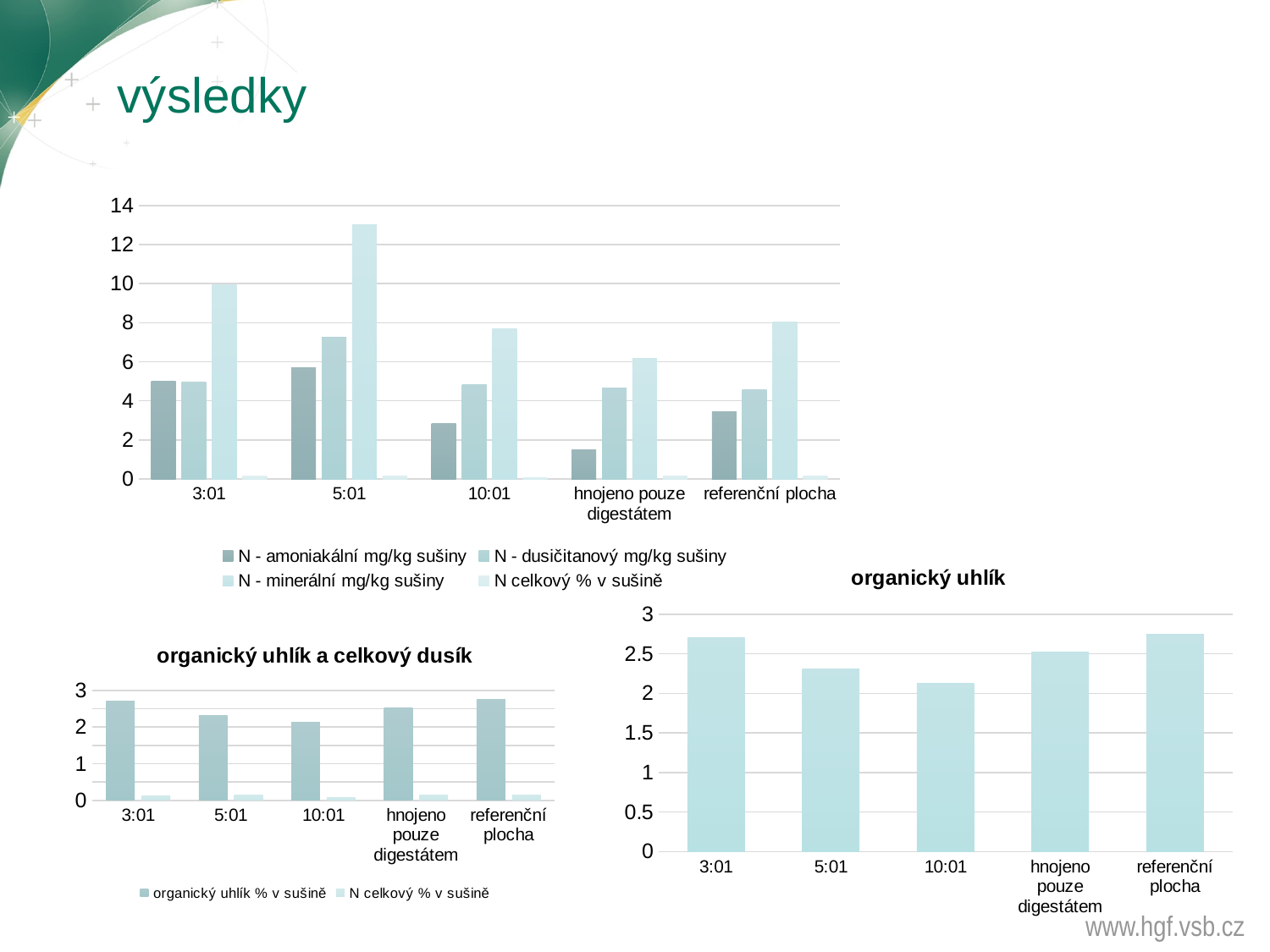
In the top chart, is the value of 'N - minerální mg/kg sušiny' for 5:01 greater or less than 12? greater In the top chart, is the value of 'N - dusičitanový mg/kg sušiny' for 10:01 greater or less than 6? less In the top chart, which is larger for 'N - minerální mg/kg sušiny': 3:01 or hnojeno pouze digestátem? 3:01 How many series does the legend of the top chart list? 4 In the chart titled 'organický uhlík', is the value for 3:01 greater or less than 2.5? greater In the chart titled 'organický uhlík', which is larger: the value for 5:01 or the value for referenční plocha? referenční plocha What kind of chart is the chart titled 'organický uhlík'? bar chart In the top chart, which category has the lowest value for 'N - amoniakální mg/kg sušiny'? hnojeno pouze digestátem In the top chart, which category has the highest value for 'N - minerální mg/kg sušiny'? 5:01 How many categories are shown on the x axis of the chart titled 'organický uhlík'? 5 How many series does the legend of the chart titled 'organický uhlík a celkový dusík' list? 2